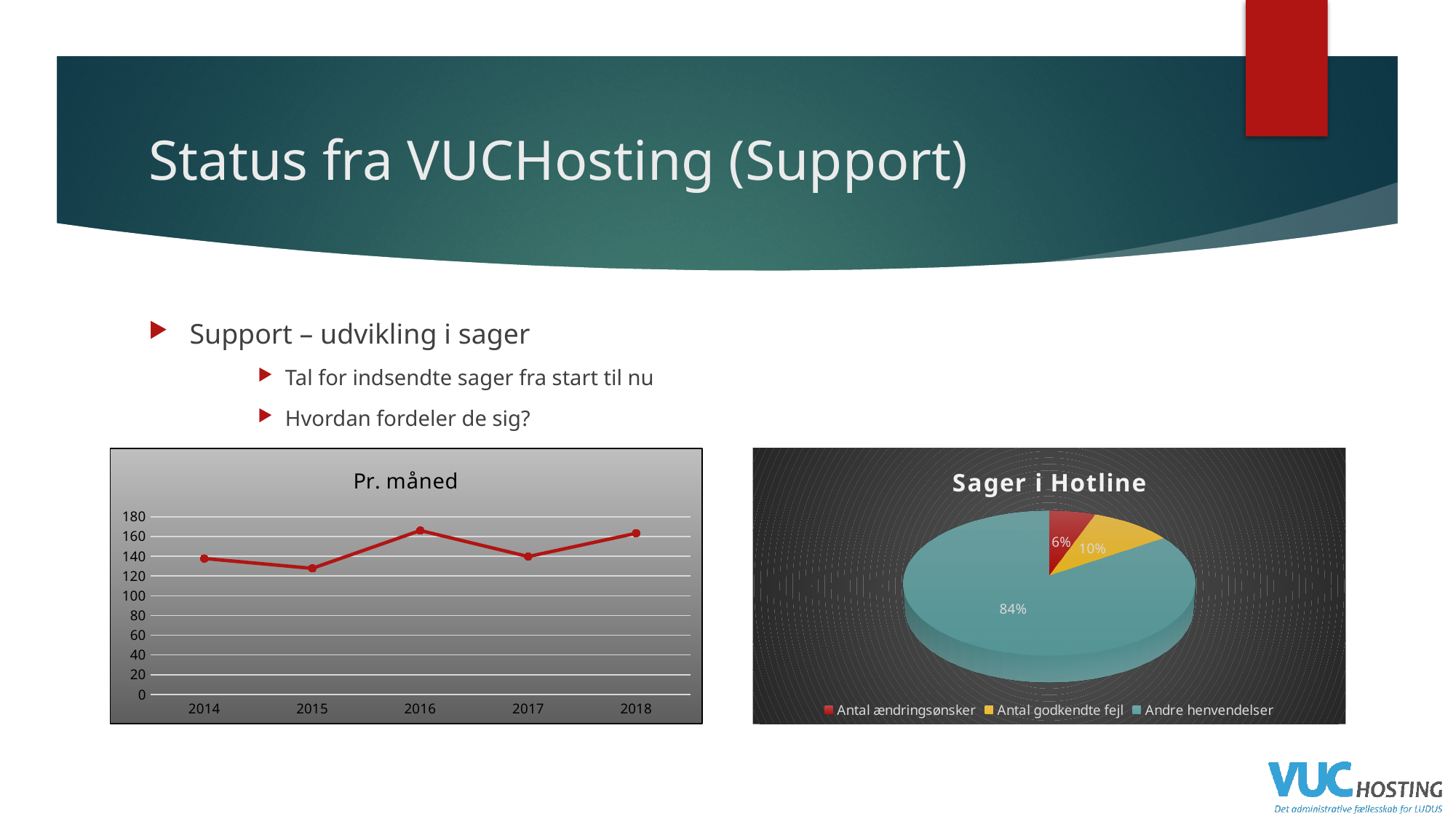
In the 'Sager i Hotline' chart, which category has the smallest slice? Antal ændringsønsker In the 'Pr. måned' chart, is the value for 2016 greater or less than 160? greater In the 'Pr. måned' chart, is the value for 2018 greater or less than 160? greater In the 'Pr. måned' chart, which year has the lowest value? 2015 In the 'Pr. måned' chart, is the value for 2015 greater or less than 140? less In the 'Pr. måned' chart, which is larger, the value for 2016 or the value for 2015? 2016 How many entries does the legend of the 'Sager i Hotline' chart list? 3 What type of chart is the 'Sager i Hotline' chart on the right? pie chart In the 'Sager i Hotline' chart, what share does 'Andre henvendelser' have? 84% In the 'Pr. måned' chart, how many years are shown on the x axis? 5 In the 'Sager i Hotline' chart, what share does 'Antal godkendte fejl' have? 10% What type of chart is the 'Pr. måned' chart on the left? line chart